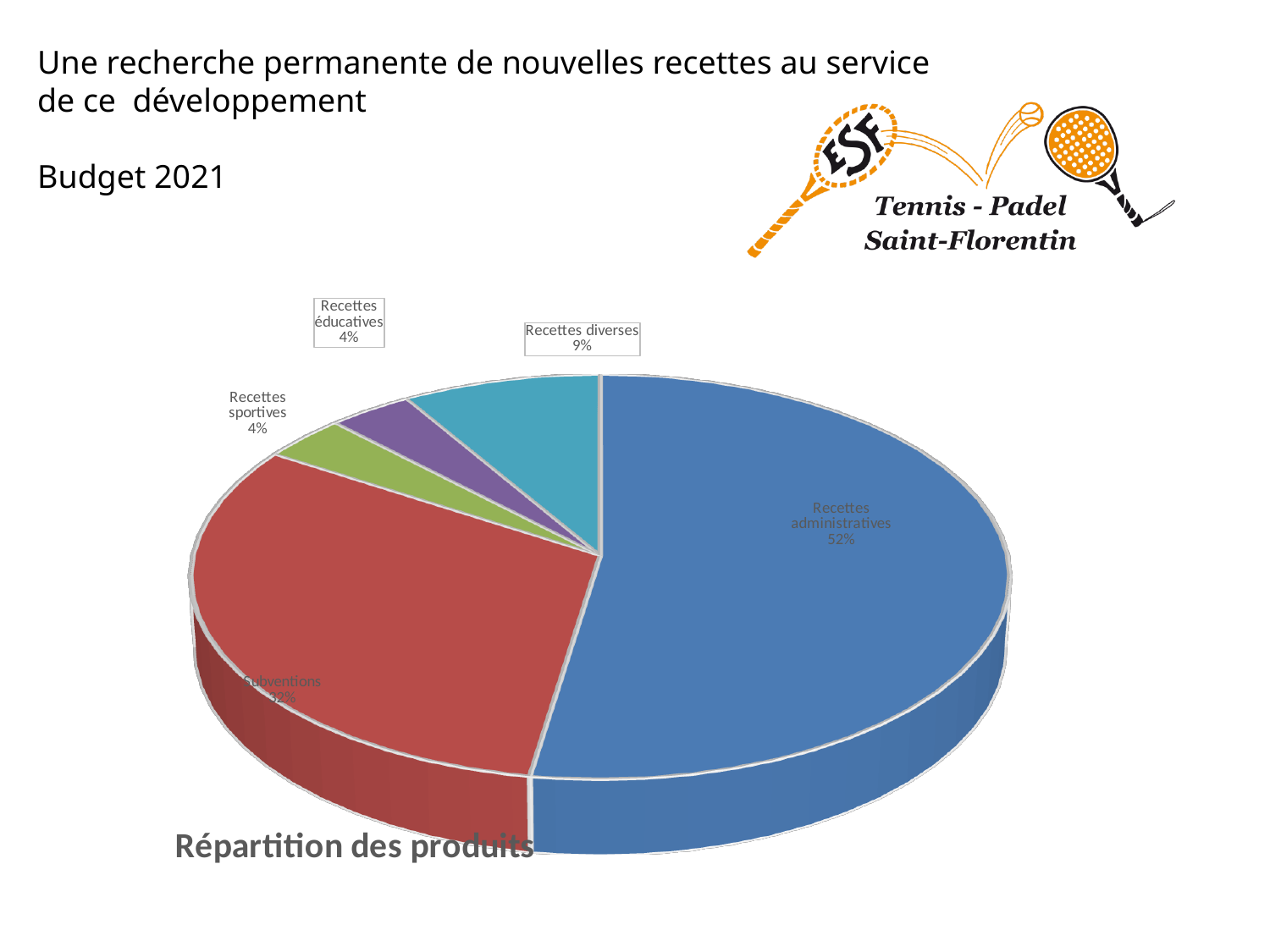
What is the difference in percentage points between Recettes administratives and Subventions? 20 Which is larger, Subventions or Recettes diverses? Subventions What share of the pie is Subventions? 32% What share of the pie is Recettes diverses? 9% What is the title of the chart? Répartition des produits What kind of chart is shown on the slide? pie chart What share of the pie is Recettes éducatives? 4% How many slices does the pie chart have? 5 Which category has the largest slice of the pie? Recettes administratives What colour is the Recettes administratives slice? blue